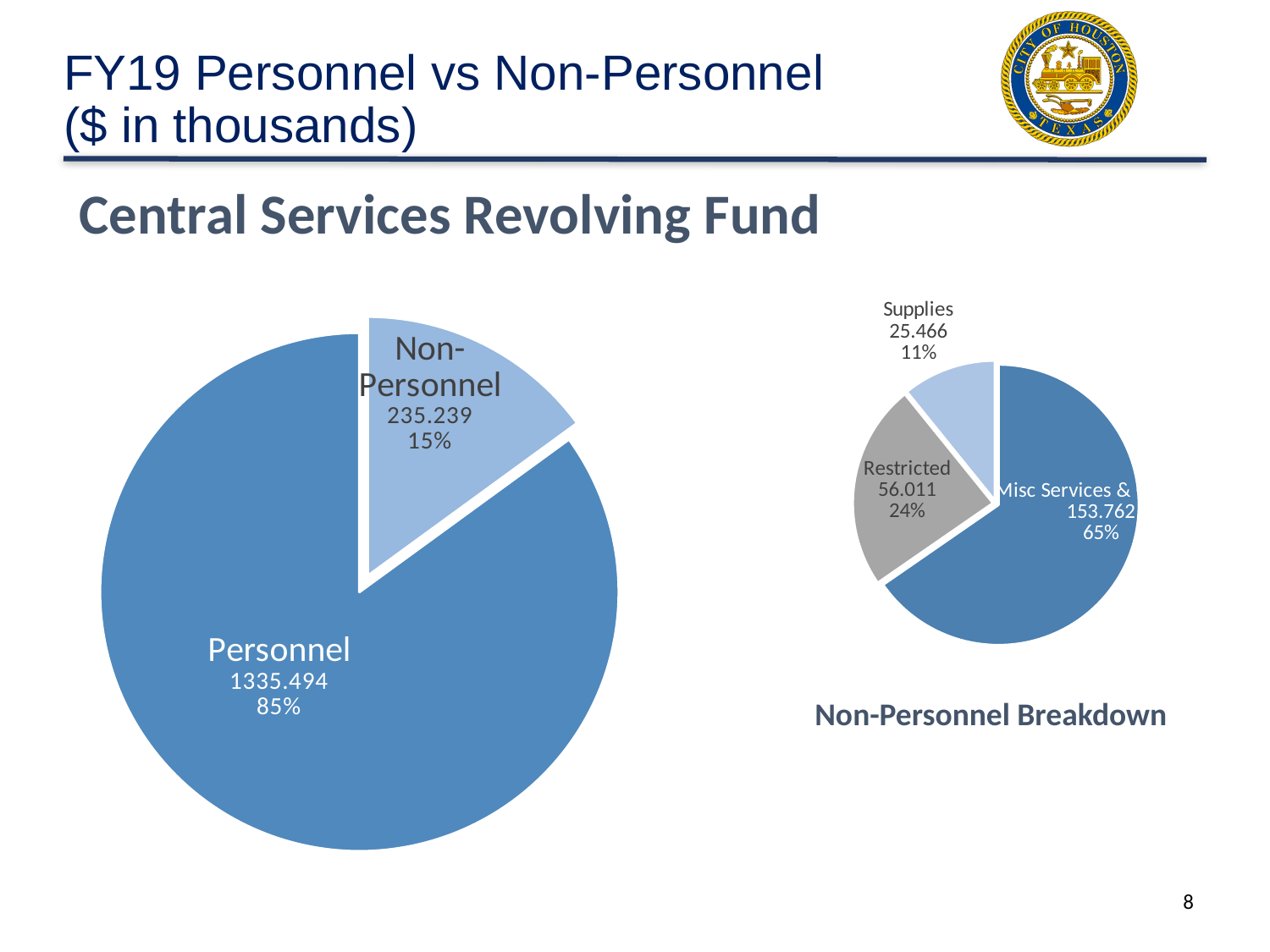
In the Non-Personnel Breakdown chart, what is the value for Restricted? 56.011 In the Non-Personnel Breakdown chart, what share of the pie is Misc Services &? 65% In the left pie chart, what is the value for Non-Personnel? 235.239 In the Non-Personnel Breakdown chart, what is the value for Supplies? 25.466 In the left pie chart, what share of the pie is Personnel? 85% In the left pie chart, what share of the pie is Non-Personnel? 15% In the Non-Personnel Breakdown chart, which category is the smallest? Supplies In the Non-Personnel Breakdown chart, which category is the largest? Misc Services & In the Non-Personnel Breakdown chart, what is the difference between Restricted and Supplies? 30.545 In the left pie chart, what is the value for Personnel? 1335.494 In the Non-Personnel Breakdown chart, how many slices does the pie have? 3 What kind of chart is the left chart? Pie chart